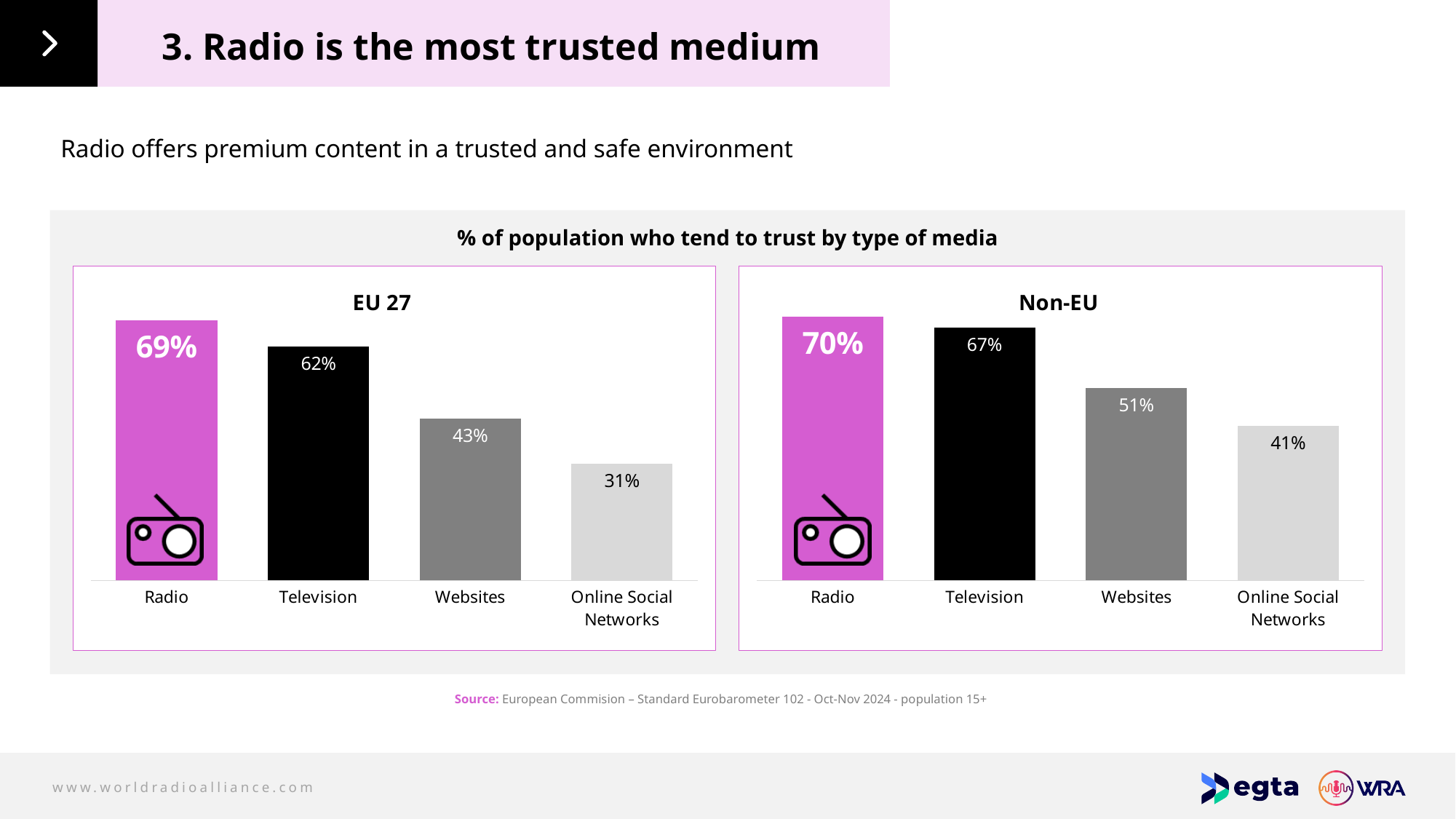
In the Non-EU chart, what is the difference between the values for Websites and Online Social Networks? 10% How many types of media are shown in the EU 27 chart? 4 What is the shared title above the two charts? % of population who tend to trust by type of media In the Non-EU chart, which type of media has the highest trust value? Radio Which is larger: the Television value in the EU 27 chart or the Television value in the Non-EU chart? Non-EU In the Non-EU chart, do the values rise or fall from Radio to Online Social Networks? Fall In the EU 27 chart, what is the difference between the values for Radio and Television? 7% In the EU 27 chart, which type of media has the lowest trust value? Online Social Networks In the EU 27 chart, what is the value for Online Social Networks? 31% In the EU 27 chart, what percentage of the population tends to trust Radio? 69% In the Non-EU chart, what percentage of the population tends to trust Websites? 51% What kind of chart is the Non-EU chart? Bar chart